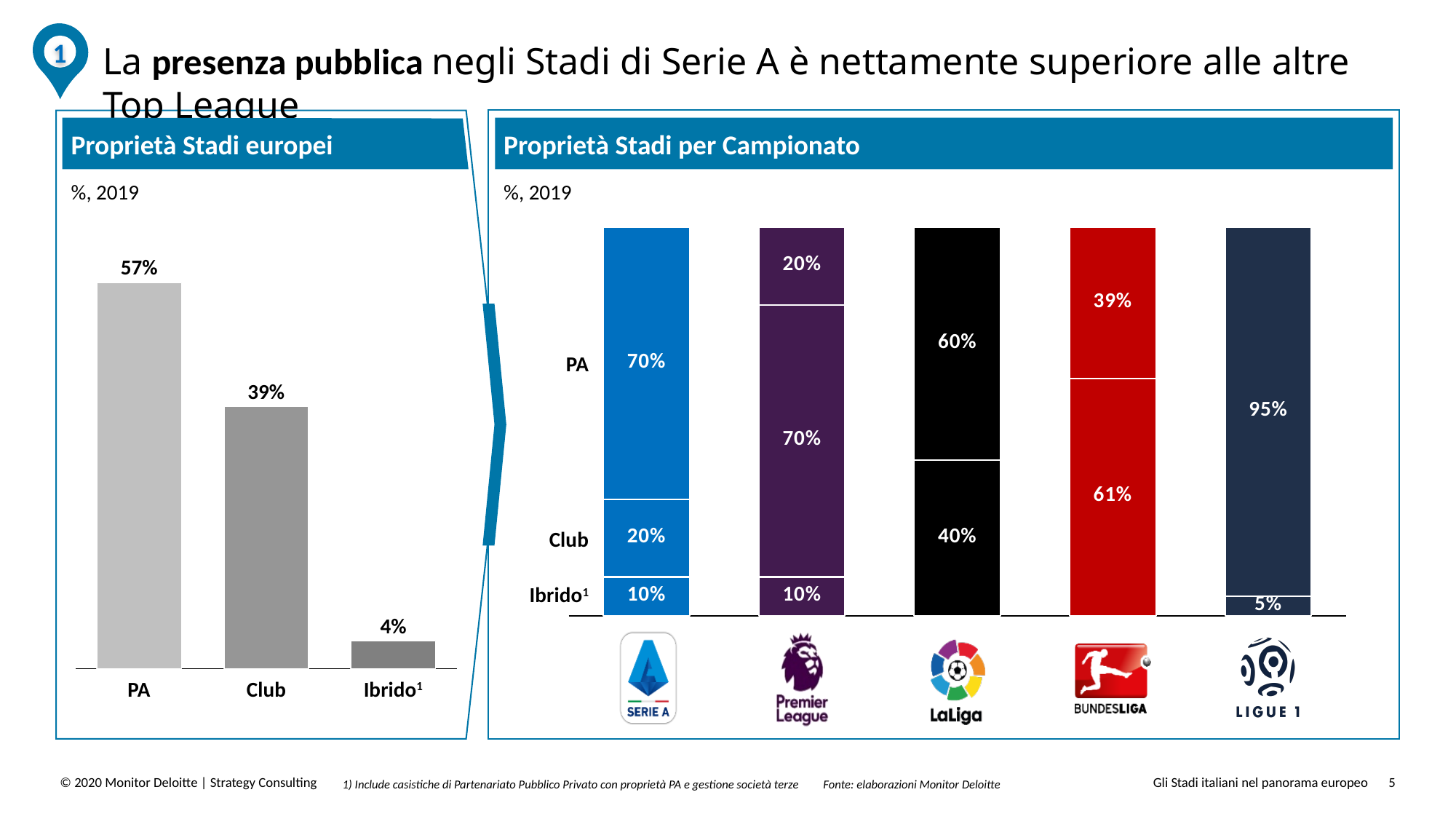
What kind of chart is the right chart 'Proprietà Stadi per Campionato'? Stacked bar chart In the left chart 'Proprietà Stadi europei', which category has the lowest value? Ibrido In the right chart 'Proprietà Stadi per Campionato', what is the value of the largest segment in the Ligue 1 bar? 95% In the right chart 'Proprietà Stadi per Campionato', what is the PA share for Serie A? 70% In the right chart 'Proprietà Stadi per Campionato', what is the value of the bottom segment of the Bundesliga bar? 61% In the right chart 'Proprietà Stadi per Campionato', how many leagues are shown? 5 In the left chart 'Proprietà Stadi europei', how many categories are shown? 3 In the right chart 'Proprietà Stadi per Campionato', what is the Ibrido share for Serie A? 10% In the left chart 'Proprietà Stadi europei', what is the value for Club? 39% In the left chart 'Proprietà Stadi europei', what is the value for PA? 57% In the left chart 'Proprietà Stadi europei', what is the difference between the PA and Club values? 18 percentage points In the right chart 'Proprietà Stadi per Campionato', what is the Club share for Serie A? 20%